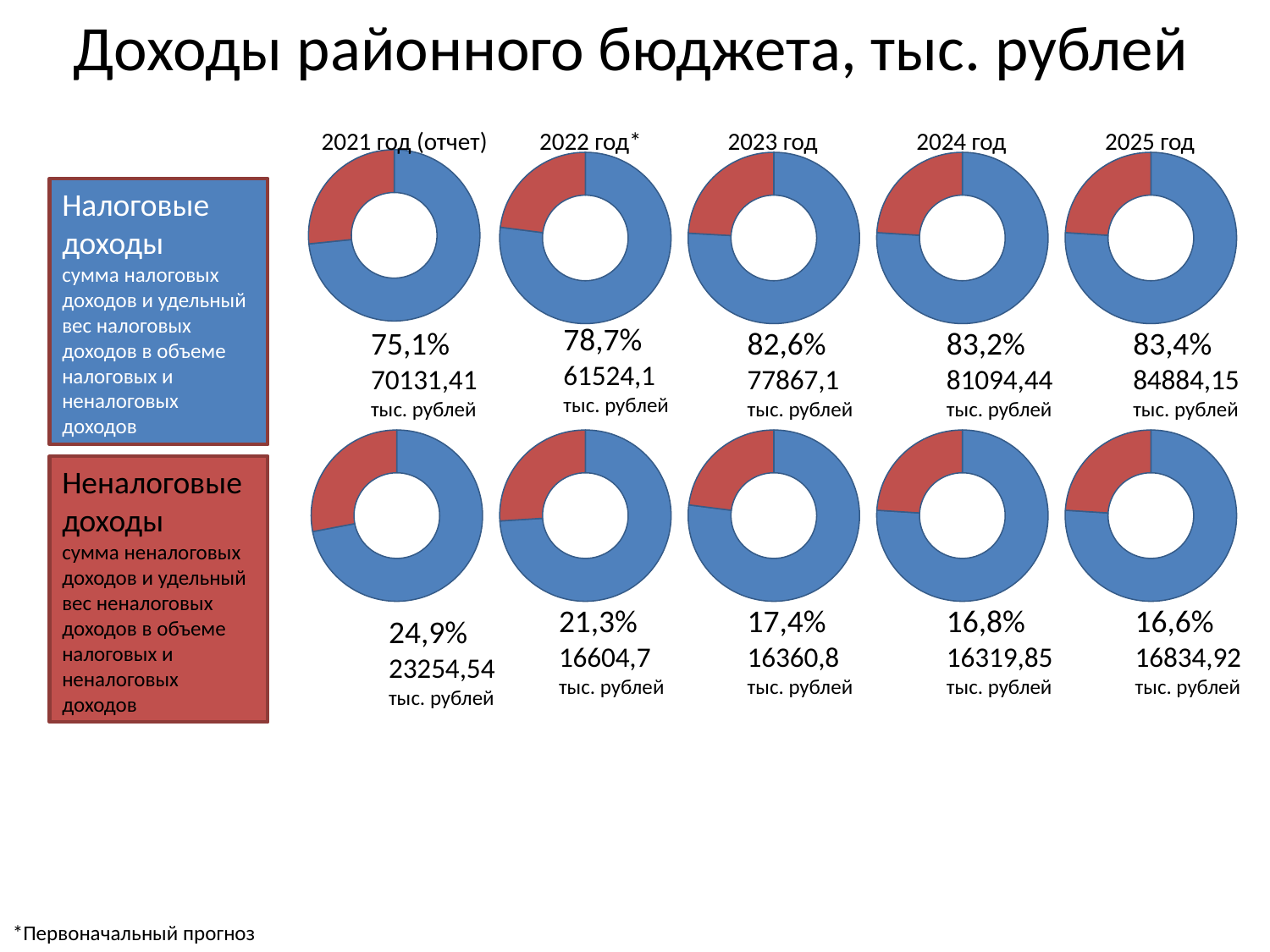
In which year is the non-tax income (Неналоговые доходы) amount the highest? 2021 год (отчет) How does the share of tax income (Налоговые доходы) change from 2021 год to 2025 год? It rises By how much does the tax income amount for 2025 год exceed that for 2021 год (отчет)? 14752,74 тыс. рублей What is the amount of non-tax income (Неналоговые доходы) shown for 2025 год? 16834,92 тыс. рублей In which year is the tax income (Налоговые доходы) amount the highest? 2025 год What is the share of tax income (Налоговые доходы) in the 2023 год chart? 82,6% What kind of chart is used on the slide? Donut (pie) chart What is the amount of tax income (Налоговые доходы) shown for 2021 год (отчет)? 70131,41 тыс. рублей Which is larger: the non-tax income amount for 2023 год or for 2024 год? 2023 год How many donut charts are shown on the slide? 10 In which year is the tax income (Налоговые доходы) amount the lowest? 2022 год* What is the share of non-tax income (Неналоговые доходы) in the 2022 год* chart? 21,3%